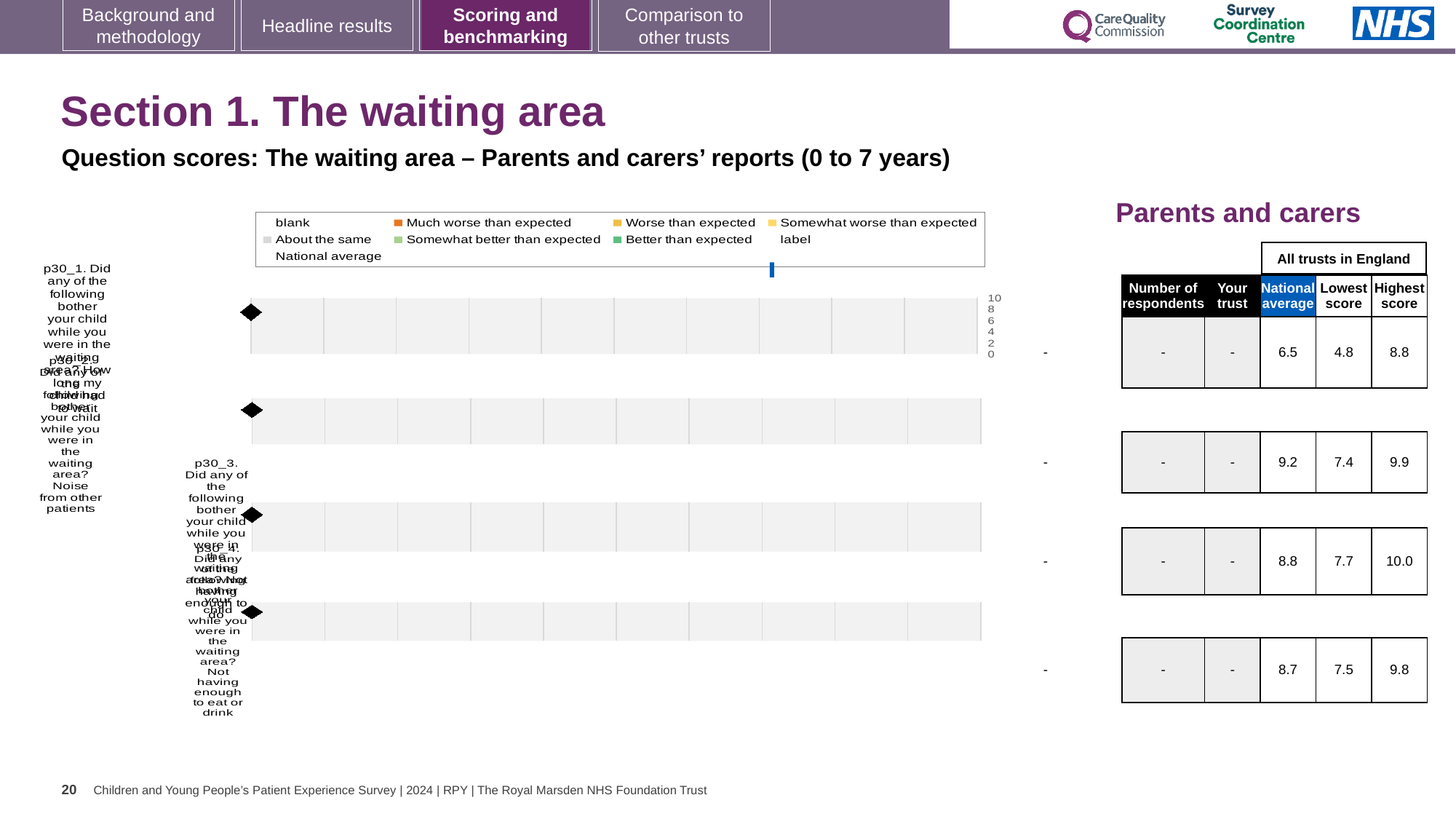
In the table beside the chart, what is the National average for the first row (p30_1, waiting area)? 6.5 What is the highest value shown on the chart's axis? 10 What kind of chart is shown on the slide? bar chart In the table beside the chart, which row has the lowest National average? p30_1 (6.5) In the table beside the chart, is the National average for the fourth row (p30_4) larger or smaller than that for the second row (p30_2)? smaller In the table beside the chart, what is the Highest score for the third row (p30_3)? 10.0 How many entries does the chart's legend list? 9 Which legend entry is shown with an orange marker? Much worse than expected How many question rows (categories) are plotted on the chart? 4 In the table beside the chart, what is the difference between the Highest score and Lowest score for the second row (p30_2)? 2.5